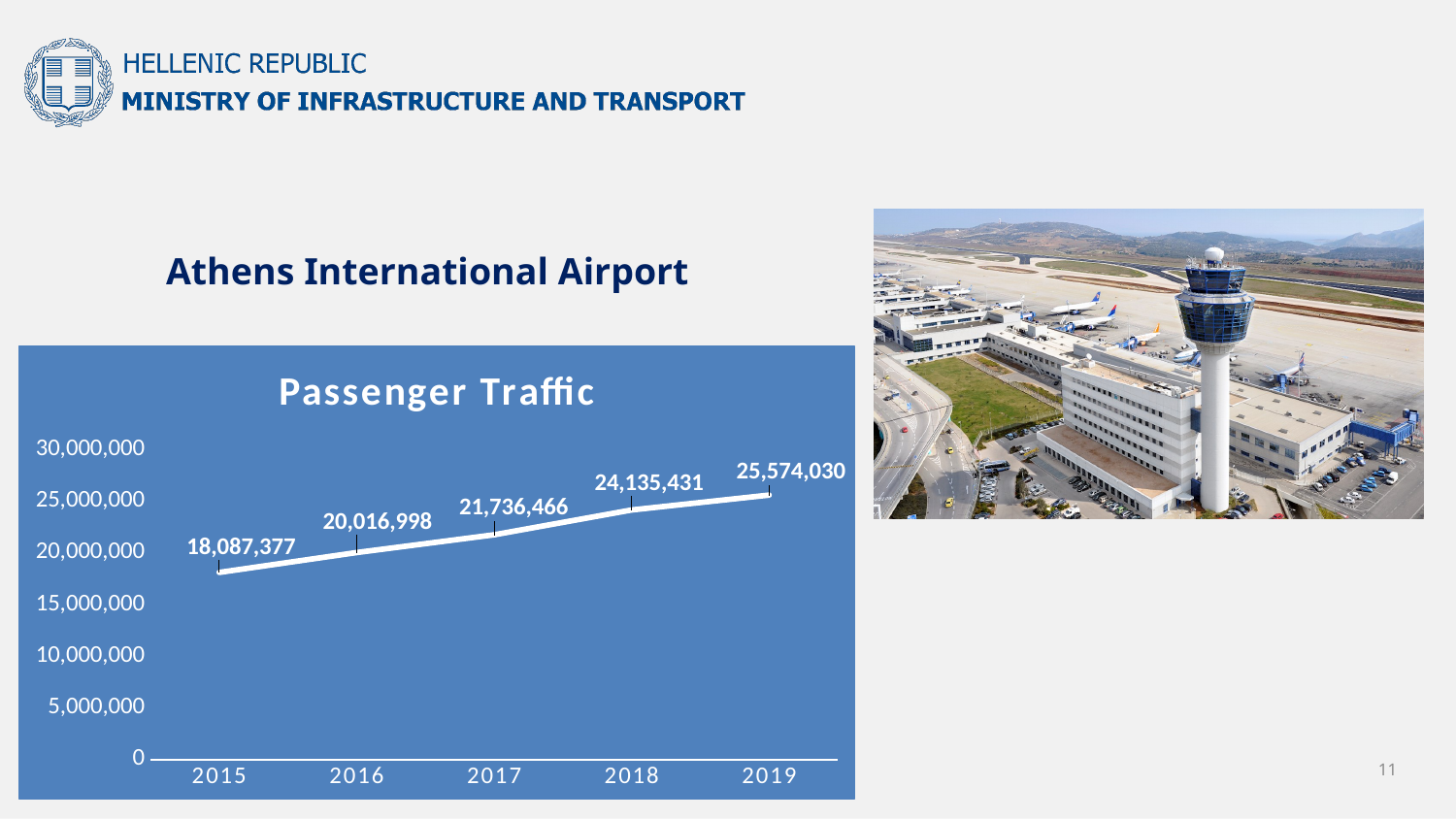
How many years are plotted on the Passenger Traffic chart? 5 What is the passenger traffic value for 2017? 21,736,466 Which year has the lowest passenger traffic? 2015 Is the passenger traffic value for 2018 greater or less than 20,000,000? greater What is the passenger traffic value for 2019? 25,574,030 What is the passenger traffic value for 2015? 18,087,377 What kind of chart is used to show Passenger Traffic? line chart By how much did passenger traffic increase from 2017 to 2018? 2,398,965 What is the difference in passenger traffic between 2019 and 2015? 7,486,653 Which year has the highest passenger traffic? 2019 Which year has higher passenger traffic, 2016 or 2018? 2018 Does passenger traffic rise or fall from 2015 to 2019? rise